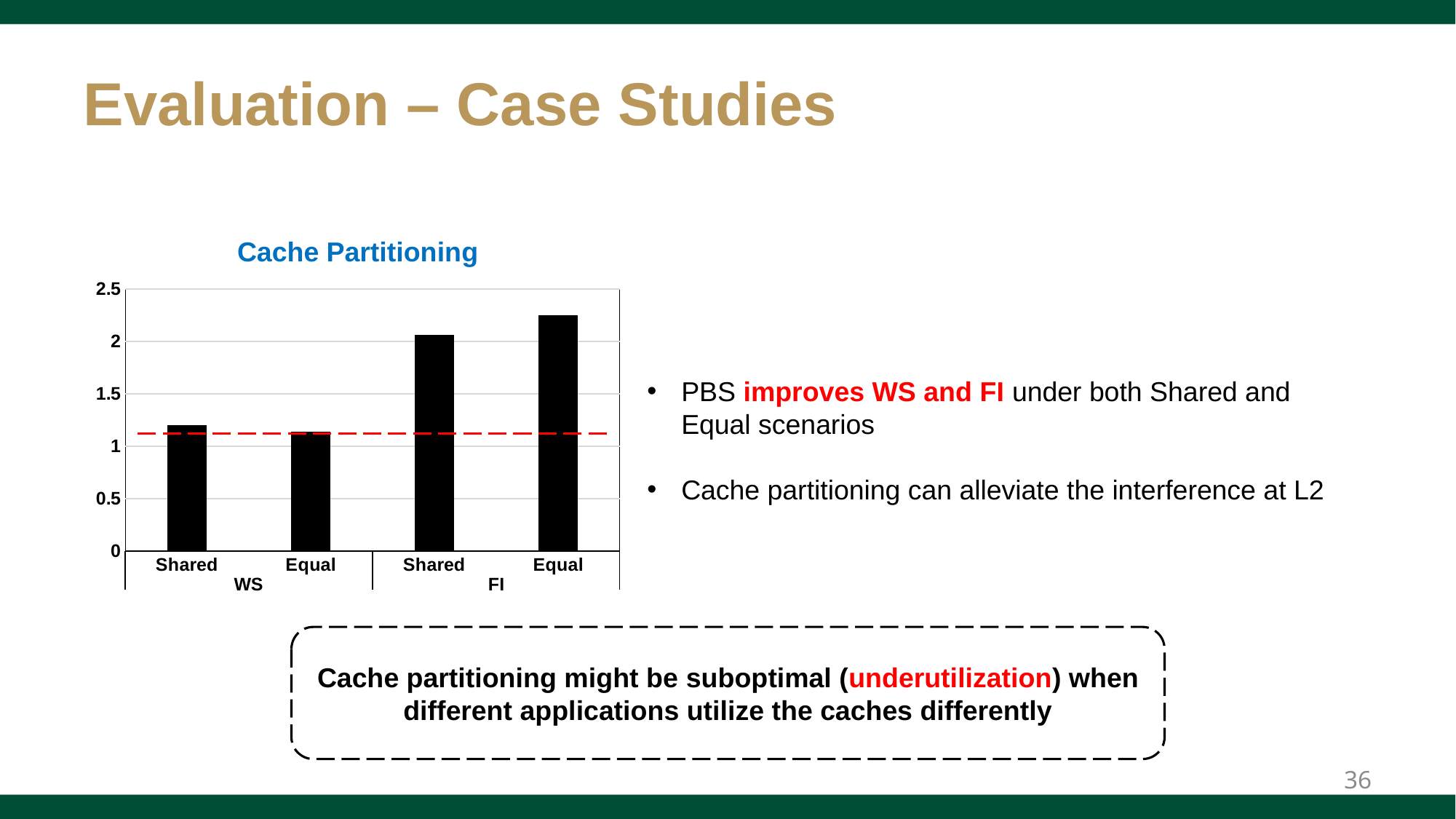
Which bar in the Cache Partitioning chart is the highest? FI Equal In the Cache Partitioning chart, which is larger: the WS Shared bar or the FI Shared bar? FI Shared Is the value for FI Equal in the Cache Partitioning chart greater or less than 2? greater Is the value for FI Shared in the Cache Partitioning chart greater or less than 2.5? less Is the value for WS Shared in the Cache Partitioning chart greater or less than 1.5? less What kind of chart is shown under the title "Cache Partitioning"? bar chart Which bar in the Cache Partitioning chart is the lowest? WS Equal What is the title of the chart on the slide? Cache Partitioning How many bars are plotted in the Cache Partitioning chart? 4 In the Cache Partitioning chart, which is larger: the FI Equal bar or the FI Shared bar? FI Equal What is the highest value shown on the y axis of the Cache Partitioning chart? 2.5